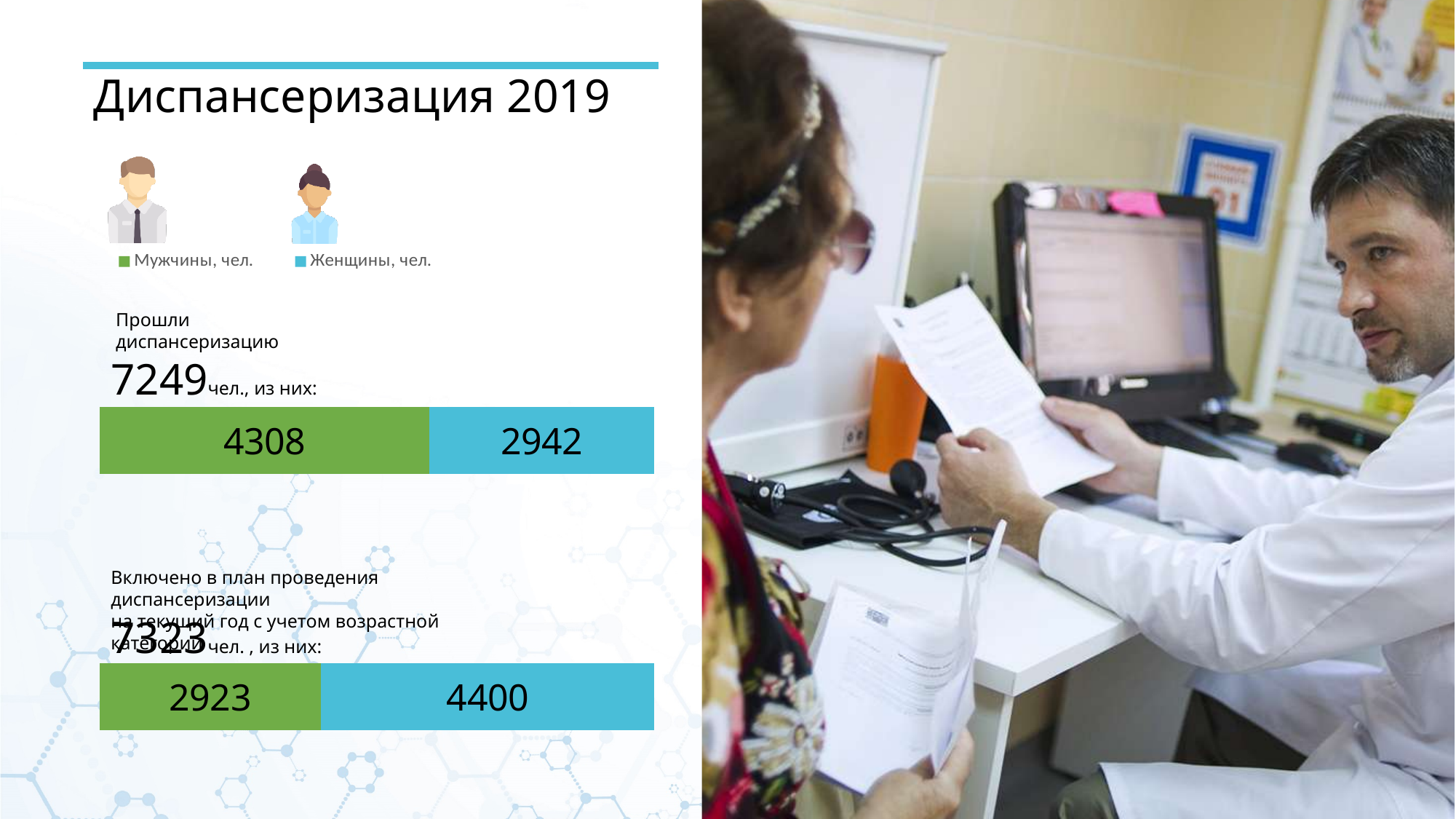
What is the total of the stacked bar in the lower chart (Включено в план проведения диспансеризации)? 7323 In the lower chart (Включено в план проведения диспансеризации), what is the value for Женщины, чел.? 4400 What kind of chart is used to show the Мужчины and Женщины values on the slide? Stacked bar chart In the lower chart, which series is larger, Мужчины or Женщины? Женщины What is the total of the stacked bar in the upper chart (Прошли диспансеризацию)? 7250 In the upper chart (Прошли диспансеризацию), what is the value for Мужчины, чел.? 4308 In the lower chart (Включено в план проведения диспансеризации), what is the value for Мужчины, чел.? 2923 In the upper chart (Прошли диспансеризацию), what is the value for Женщины, чел.? 2942 In the upper chart, which series is larger, Мужчины or Женщины? Мужчины In the upper chart, what is the difference between the values for Мужчины and Женщины? 1366 In the lower chart, what is the difference between the values for Женщины and Мужчины? 1477 How many series does the legend list for the charts on the slide? 2